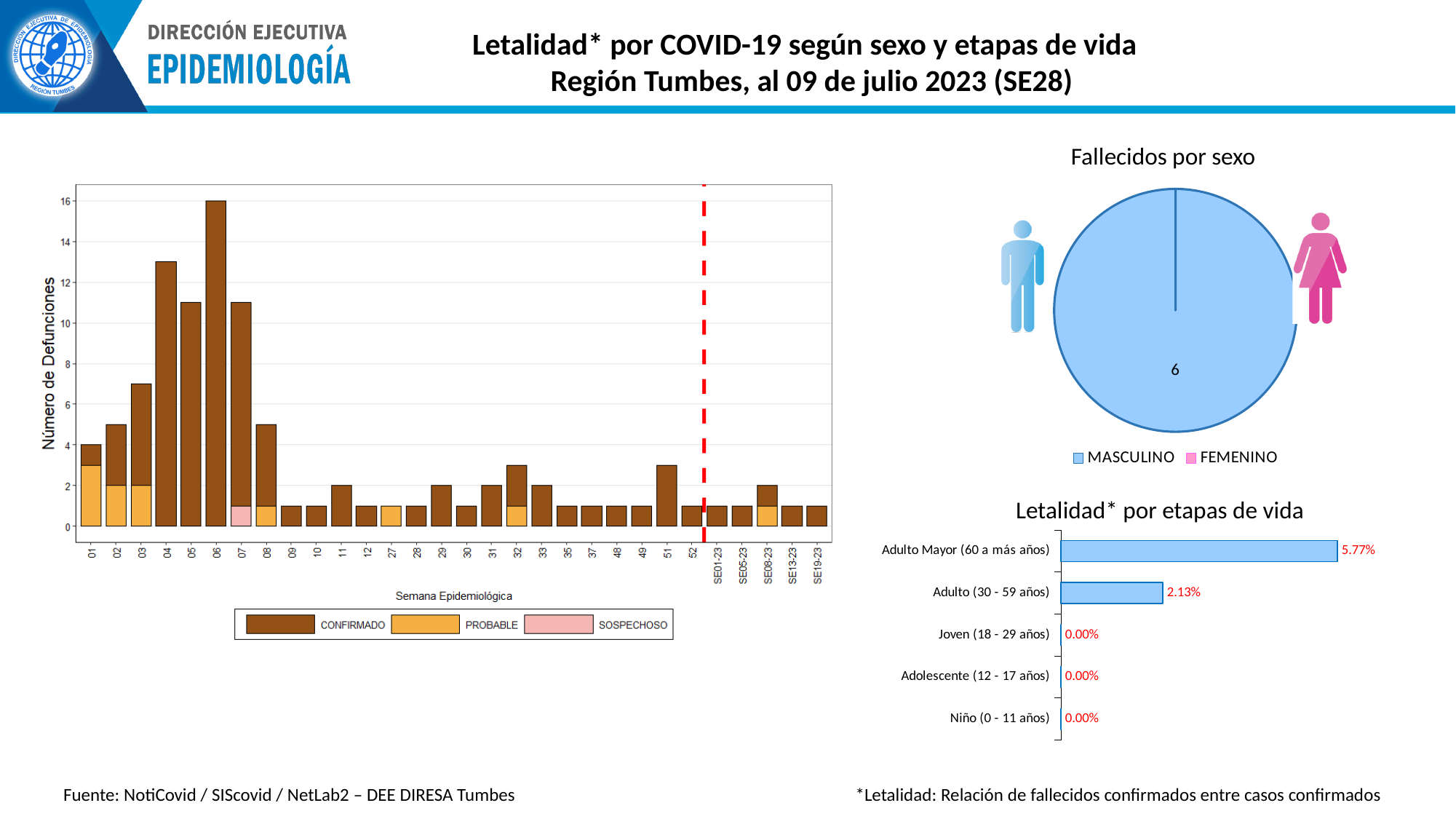
What kind of chart is 'Fallecidos por sexo'? pie chart In the 'Número de Defunciones' chart on the left, is the total for week 04 greater or less than 12? greater In the 'Fallecidos por sexo' chart, how many entries does the legend list? 2 In the 'Número de Defunciones' chart on the left, what is the total number of deaths in week 06? 16 In the 'Letalidad* por etapas de vida' chart, what is the value for Adulto (30 - 59 años)? 2.13% In the 'Letalidad* por etapas de vida' chart, what is the value for Adulto Mayor (60 a más años)? 5.77% In the 'Letalidad* por etapas de vida' chart, how many age groups are shown? 5 In the 'Letalidad* por etapas de vida' chart, which age group has the highest value? Adulto Mayor (60 a más años) In the 'Número de Defunciones' chart on the left, how many series does the legend list? 3 In the 'Fallecidos por sexo' pie chart, what value is shown for the MASCULINO slice? 6 In the 'Letalidad* por etapas de vida' chart, what is the difference between the values for Adulto Mayor (60 a más años) and Adulto (30 - 59 años)? 3.64% In the 'Número de Defunciones' chart on the left, which epidemiological week has the highest number of deaths? 06